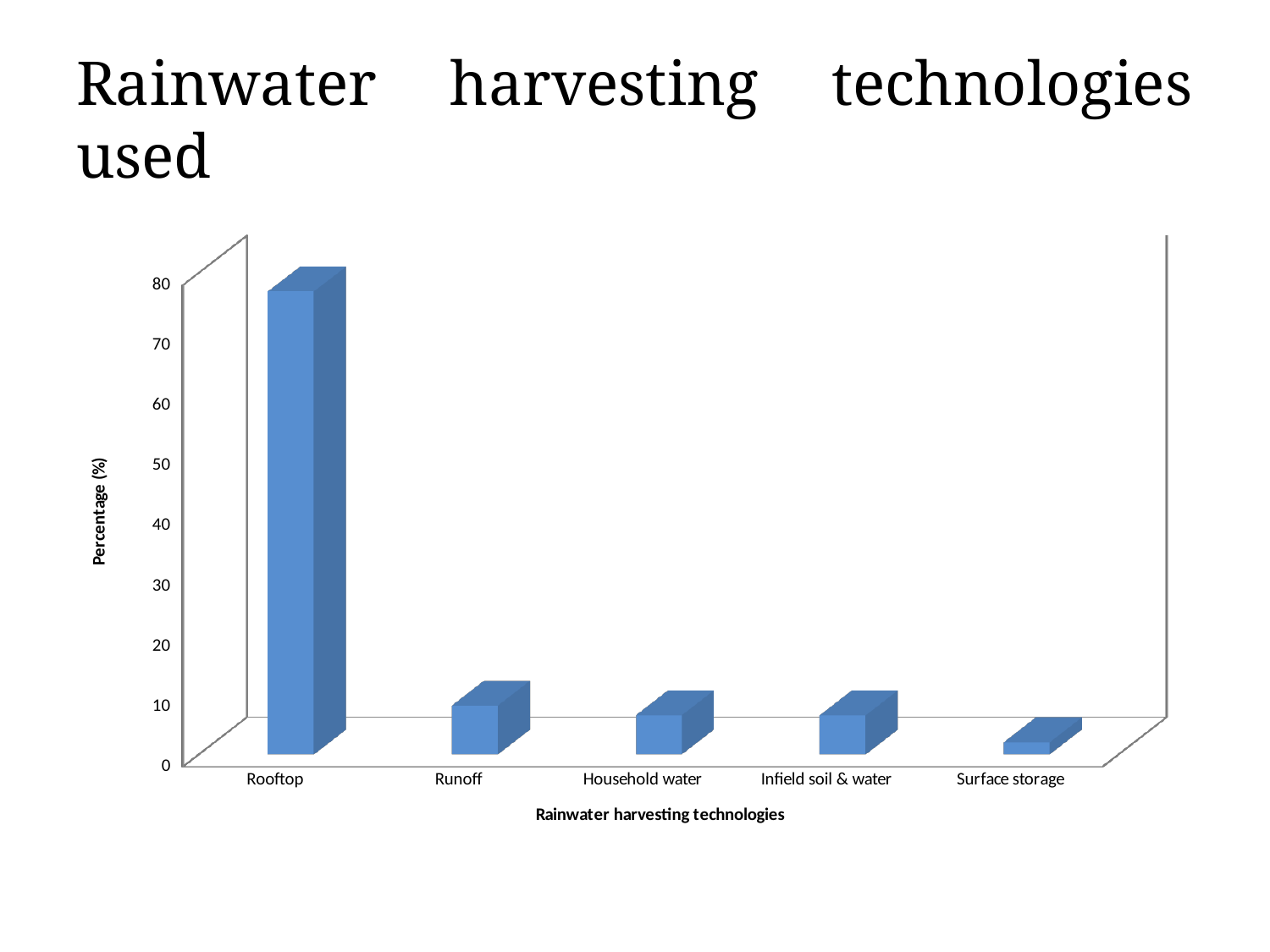
Is the value for Rooftop greater or less than 70? greater Which rainwater harvesting technology has the lowest percentage? Surface storage Which has a higher percentage, Rooftop or Runoff? Rooftop What is the title of the vertical axis? Percentage (%) How many rainwater harvesting technologies are shown on the x axis? 5 What is the title of the horizontal axis? Rainwater harvesting technologies What kind of chart is shown on the slide? bar chart Do the values generally rise or fall moving from left to right along the x axis? fall Which has a higher percentage, Runoff or Surface storage? Runoff Is the value for Runoff greater or less than 10? less Which rainwater harvesting technology has the highest percentage? Rooftop Is the value for Surface storage greater or less than 10? less